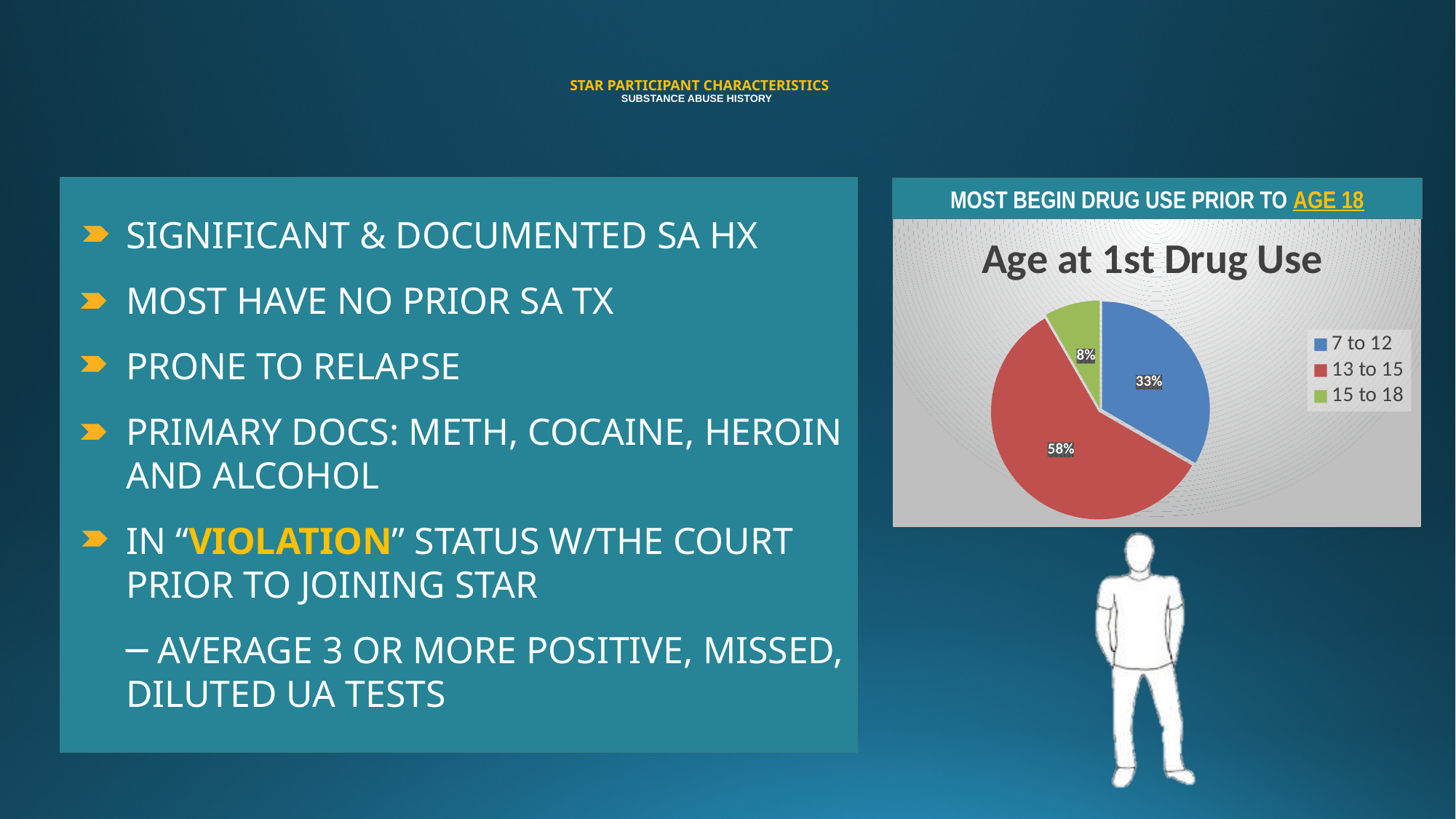
Which slice is larger, 7 to 12 or 15 to 18? 7 to 12 How many categories does the legend list? 3 What colour is the slice for the 13 to 15 age group? red What is the title of the chart? Age at 1st Drug Use What percentage of participants first used drugs at age 15 to 18? 8% Which age group has the largest share of the pie? 13 to 15 Which age group has the smallest share of the pie? 15 to 18 What is the difference in percentage points between the 13 to 15 and 7 to 12 slices? 25 What percentage of participants first used drugs at age 7 to 12? 33% What is the combined share of the 7 to 12 and 13 to 15 slices? 91% What type of chart is shown on the slide? pie chart What percentage of participants first used drugs at age 13 to 15? 58%